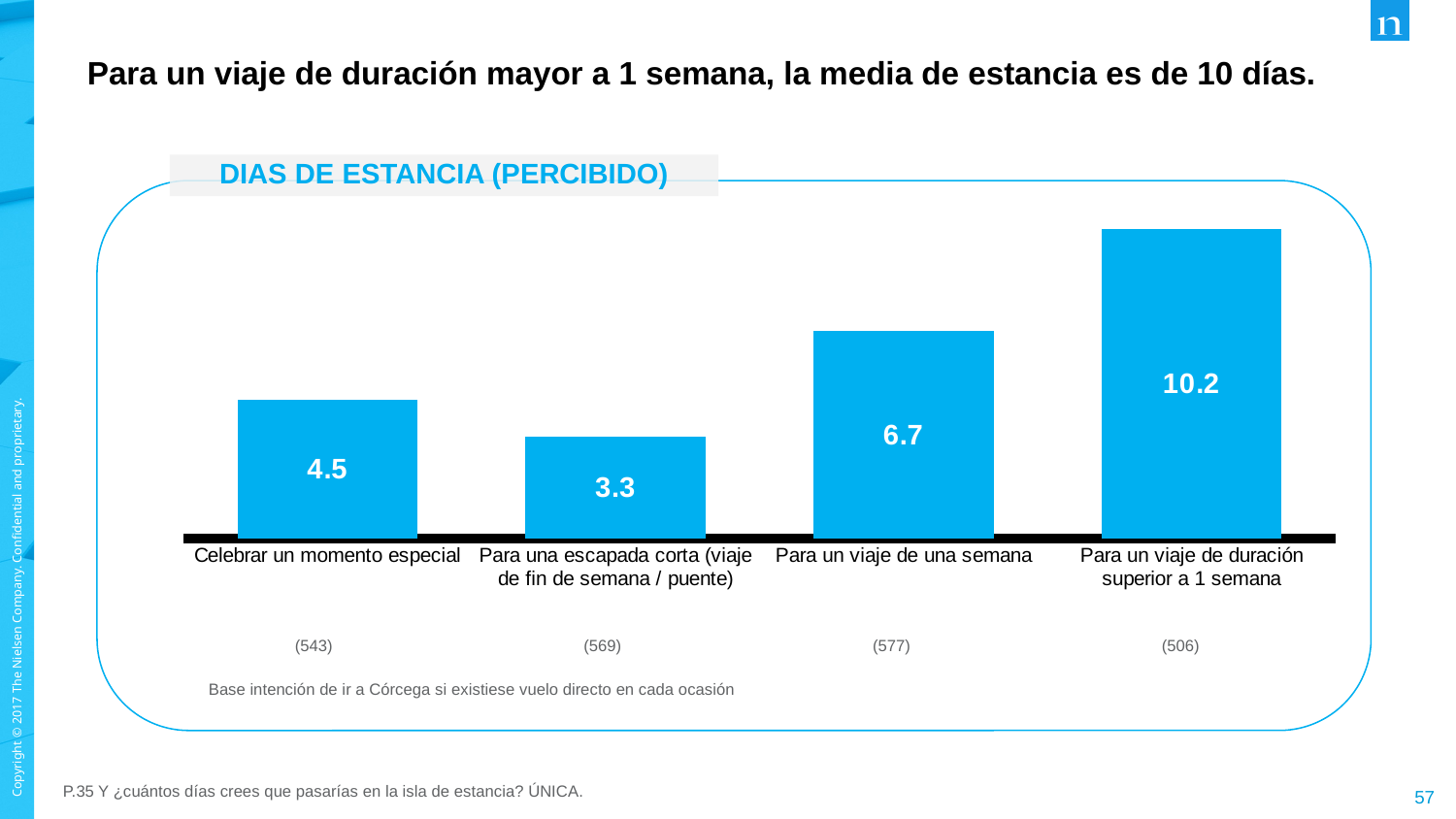
What is the difference between the values for 'Para un viaje de duración superior a 1 semana' and 'Para un viaje de una semana'? 3.5 What is the value for 'Celebrar un momento especial'? 4.5 Which category has the highest value? Para un viaje de duración superior a 1 semana What is the value for 'Para un viaje de una semana'? 6.7 What is the difference between the values for 'Celebrar un momento especial' and 'Para una escapada corta (viaje de fin de semana / puente)'? 1.2 What is the title of the chart? DIAS DE ESTANCIA (PERCIBIDO) What kind of chart is shown on the slide? Bar chart Which is larger, the value for 'Celebrar un momento especial' or for 'Para un viaje de una semana'? Para un viaje de una semana How many categories are shown in the chart? 4 Which category has the lowest value? Para una escapada corta (viaje de fin de semana / puente) What is the value for 'Para un viaje de duración superior a 1 semana'? 10.2 What is the value for 'Para una escapada corta (viaje de fin de semana / puente)'? 3.3